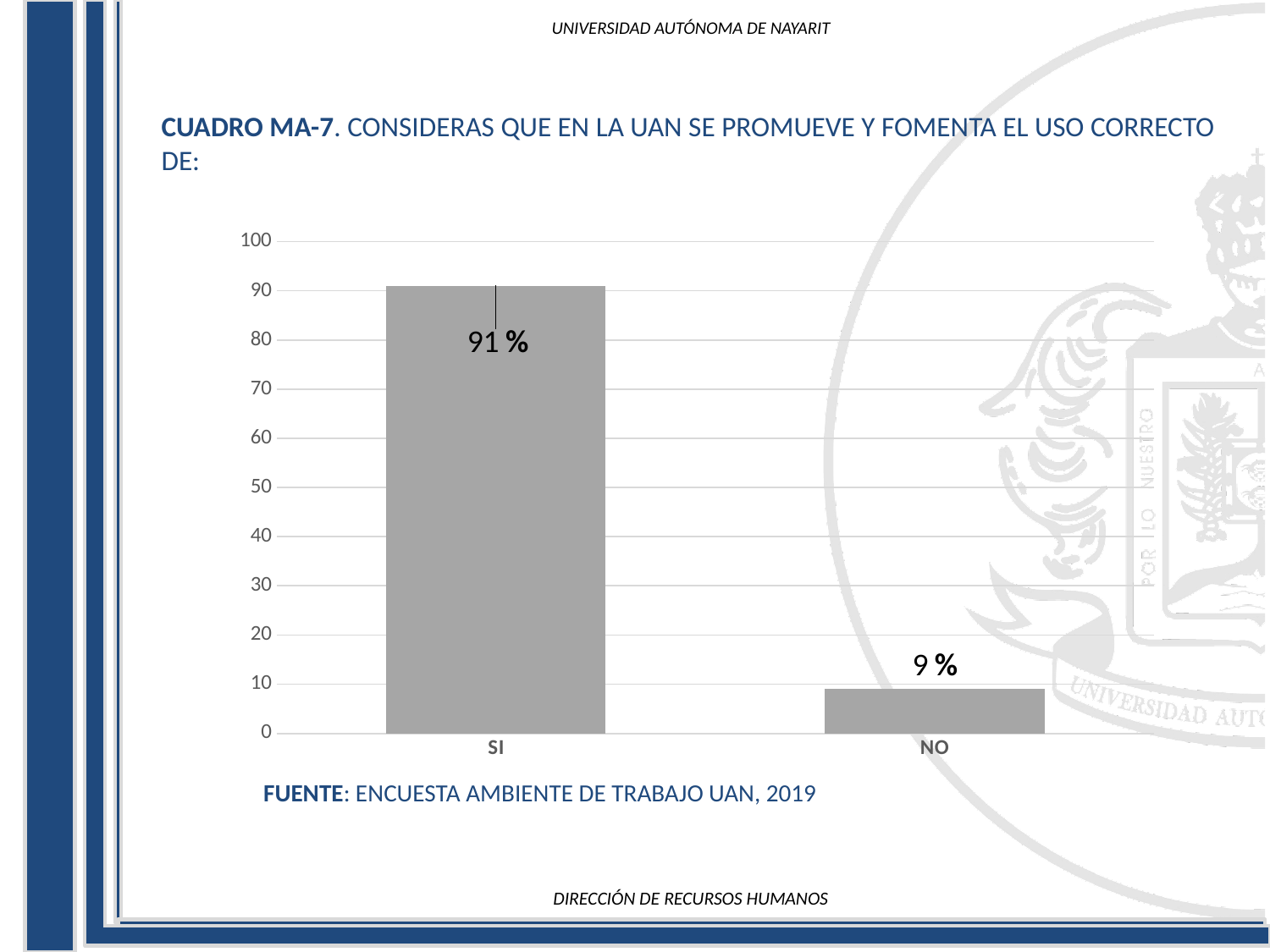
What is the value for SI? 91 % How many categories are shown on the x axis? 2 What is the difference between the values for SI and NO? 82 % Is the value for NO greater or less than 20? less What kind of chart is shown on the slide? bar chart What is the value for NO? 9 % What is the highest value shown on the y axis? 100 Which is larger, the value for SI or the value for NO? SI What is the source cited below the chart? ENCUESTA AMBIENTE DE TRABAJO UAN, 2019 Is the value for SI greater or less than 80? greater Which category has the lowest value? NO Which category has the highest value? SI